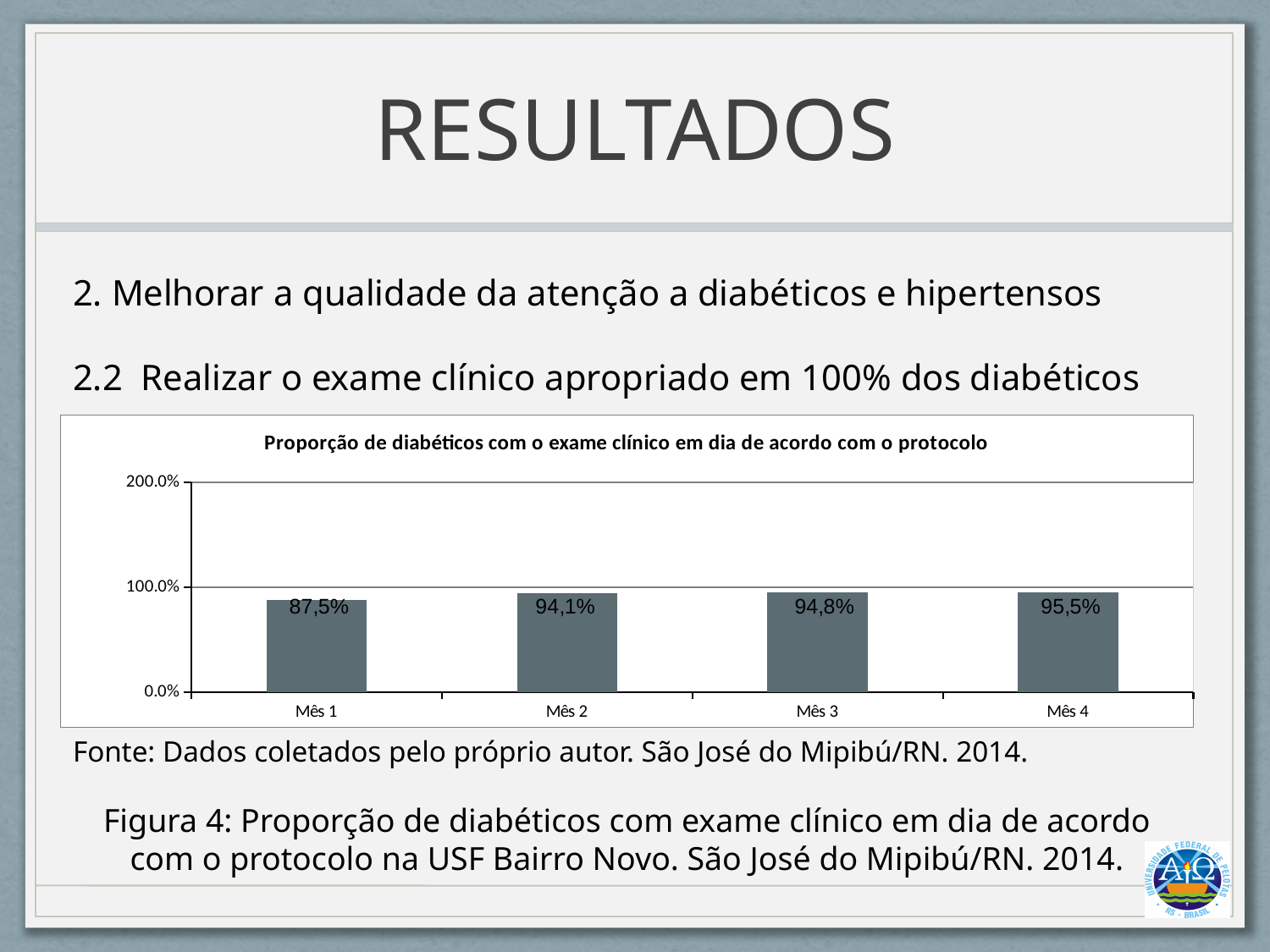
What is the value for Mês 3? 94,8% Which is larger, the value for Mês 2 or the value for Mês 1? Mês 2 Do the values rise or fall from Mês 1 to Mês 4? rise What is the value for Mês 1? 87,5% Which month has the lowest value? Mês 1 Which month has the highest value? Mês 4 What is the title of the chart? Proporção de diabéticos com o exame clínico em dia de acordo com o protocolo What is the value for Mês 4? 95,5% What kind of chart is shown? bar chart Is the value for Mês 2 greater or less than 100.0%? less What is the difference between the values for Mês 4 and Mês 1? 8,0% How many months are shown on the x axis? 4